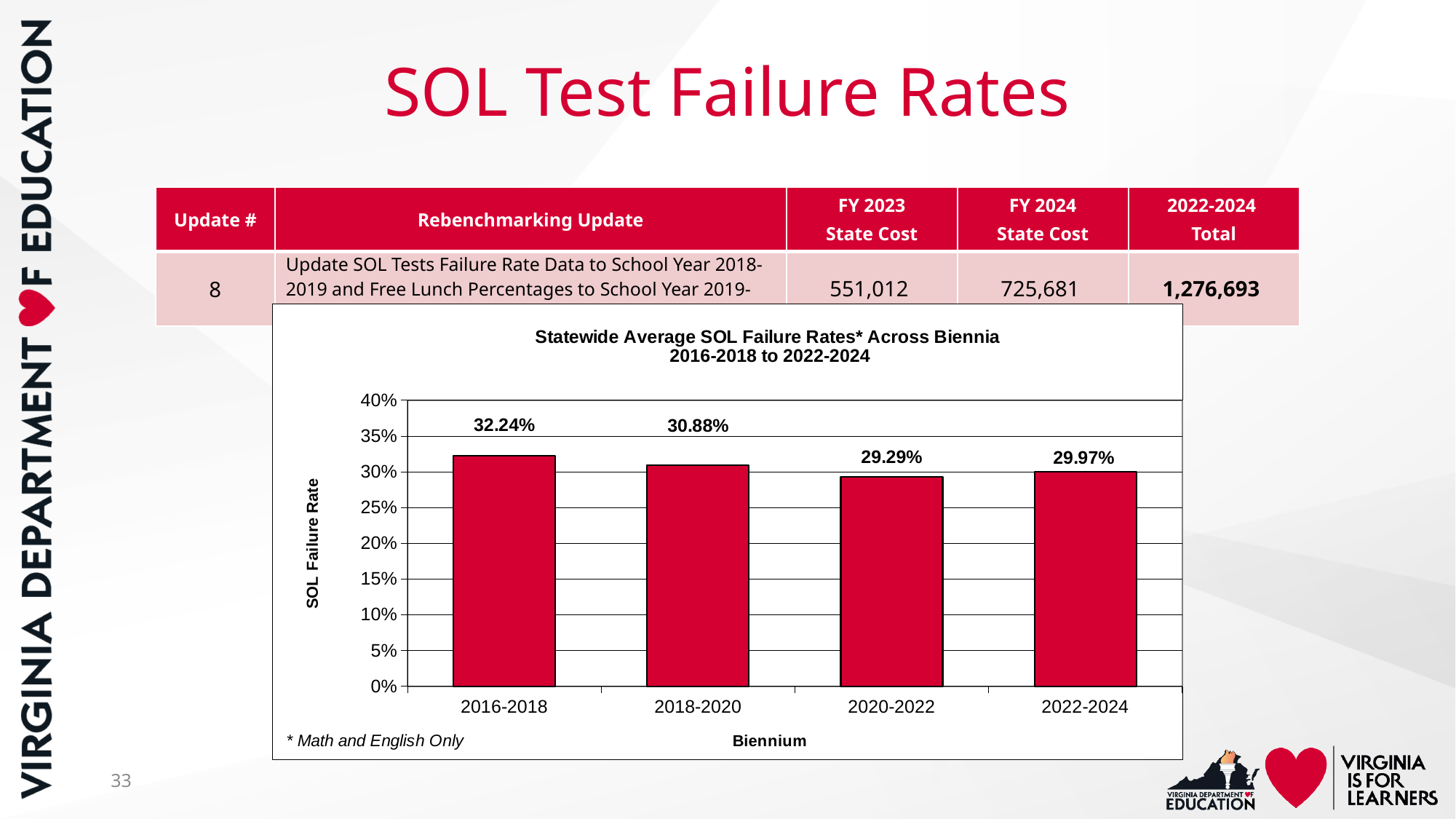
Which biennium has the highest SOL failure rate? 2016-2018 Which biennium has the lowest SOL failure rate? 2020-2022 Which biennium has a higher failure rate, 2018-2020 or 2022-2024? 2018-2020 What is the SOL failure rate for the 2022-2024 biennium? 29.97% Is the failure rate for 2020-2022 greater or less than 30%? less How many biennia are shown in the chart? 4 What is the difference in failure rate between the 2016-2018 and 2022-2024 biennia? 2.27% What is the label on the y-axis of the chart? SOL Failure Rate What is the SOL failure rate for the 2020-2022 biennium? 29.29% What is the SOL failure rate for the 2016-2018 biennium? 32.24% What is the SOL failure rate for the 2018-2020 biennium? 30.88% What type of chart is used to show the SOL failure rates? bar chart